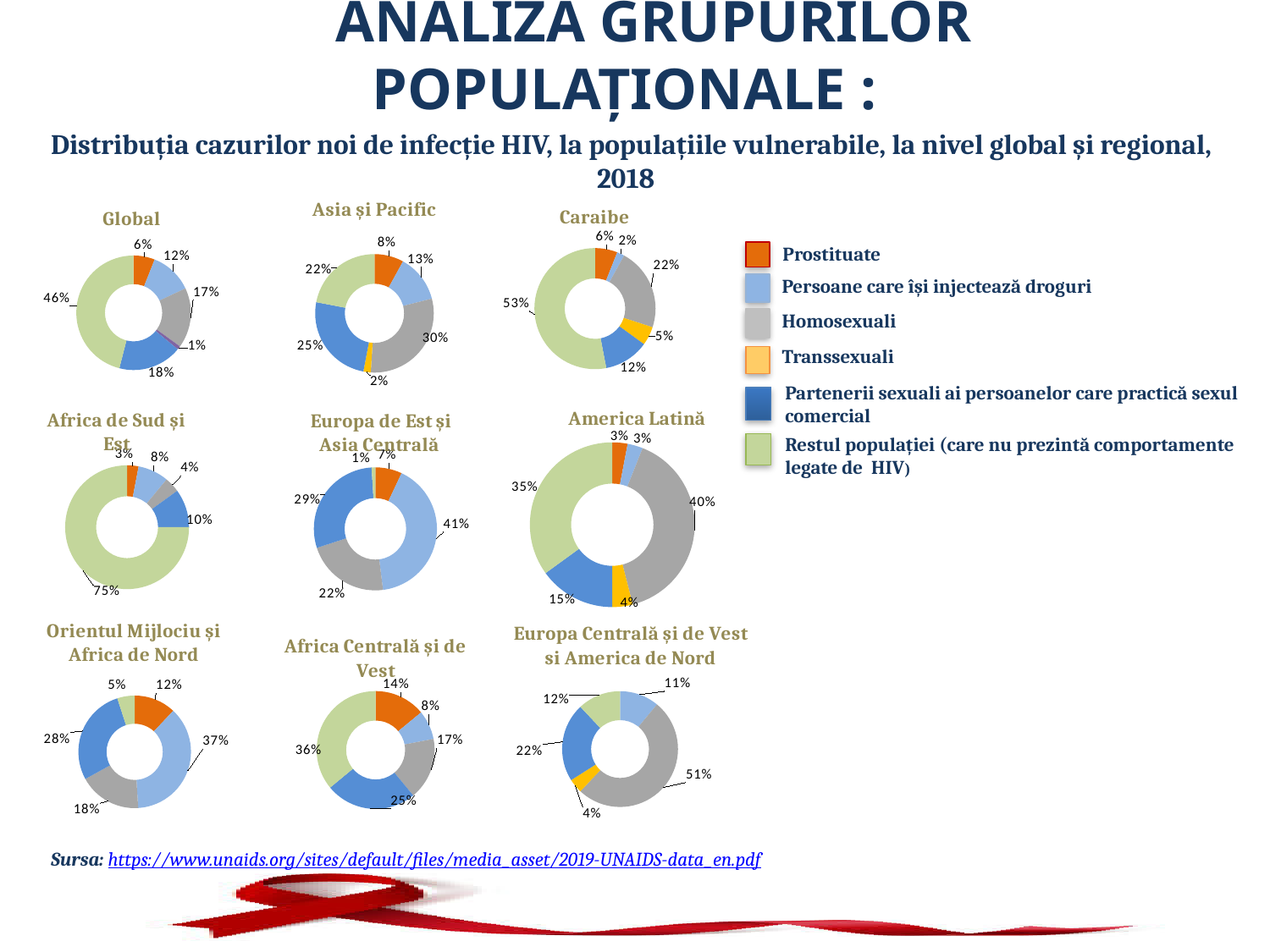
In the America Latină chart, which group has the largest share? Homosexuali In the Asia și Pacific chart, what is the share for 'Homosexuali'? 30% In the Global chart, what share of new HIV infections is attributed to 'Restul populației'? 46% In the Europa de Est și Asia Centrală chart, what is the share for 'Persoane care își injectează droguri'? 41% How many entries does the legend list? 6 In the Caraibe chart, which group has the largest share? Restul populației In the Africa Centrală și de Vest chart, which is larger: the share for 'Prostituate' or the share for 'Homosexuali'? Homosexuali What kind of chart is used for each region on the slide? Donut (pie) chart How many regional/global donut charts are shown on the slide? 9 In the Orientul Mijlociu și Africa de Nord chart, what is the difference between the share for 'Persoane care își injectează droguri' and the share for 'Homosexuali'? 19% In the Europa Centrală și de Vest si America de Nord chart, what is the share for 'Homosexuali'? 51% In the Africa de Sud și Est chart, what is the share for 'Restul populației'? 75%